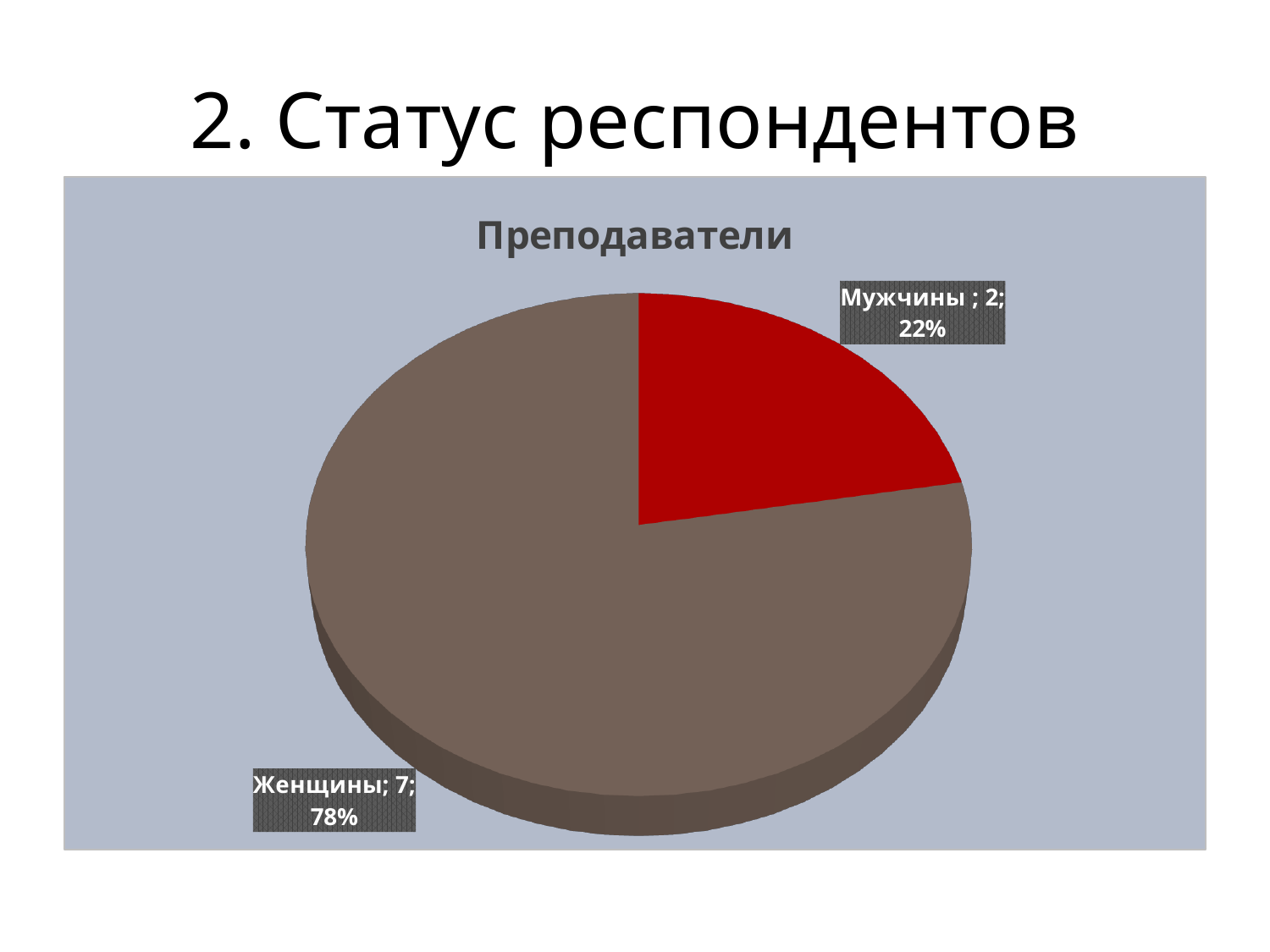
What share of the pie does the Мужчины slice represent? 22% What share of the pie does the Женщины slice represent? 78% What is the value for Мужчины? 2 What colour is the Мужчины slice? red How many slices does the pie chart have? 2 What is the title of the chart? Преподаватели Which category has the largest slice? Женщины Which category has the smallest slice? Мужчины Which is larger, the value for Женщины or the value for Мужчины? Женщины What is the difference between the values for Женщины and Мужчины? 5 What kind of chart is shown on the slide? pie chart What is the value for Женщины? 7